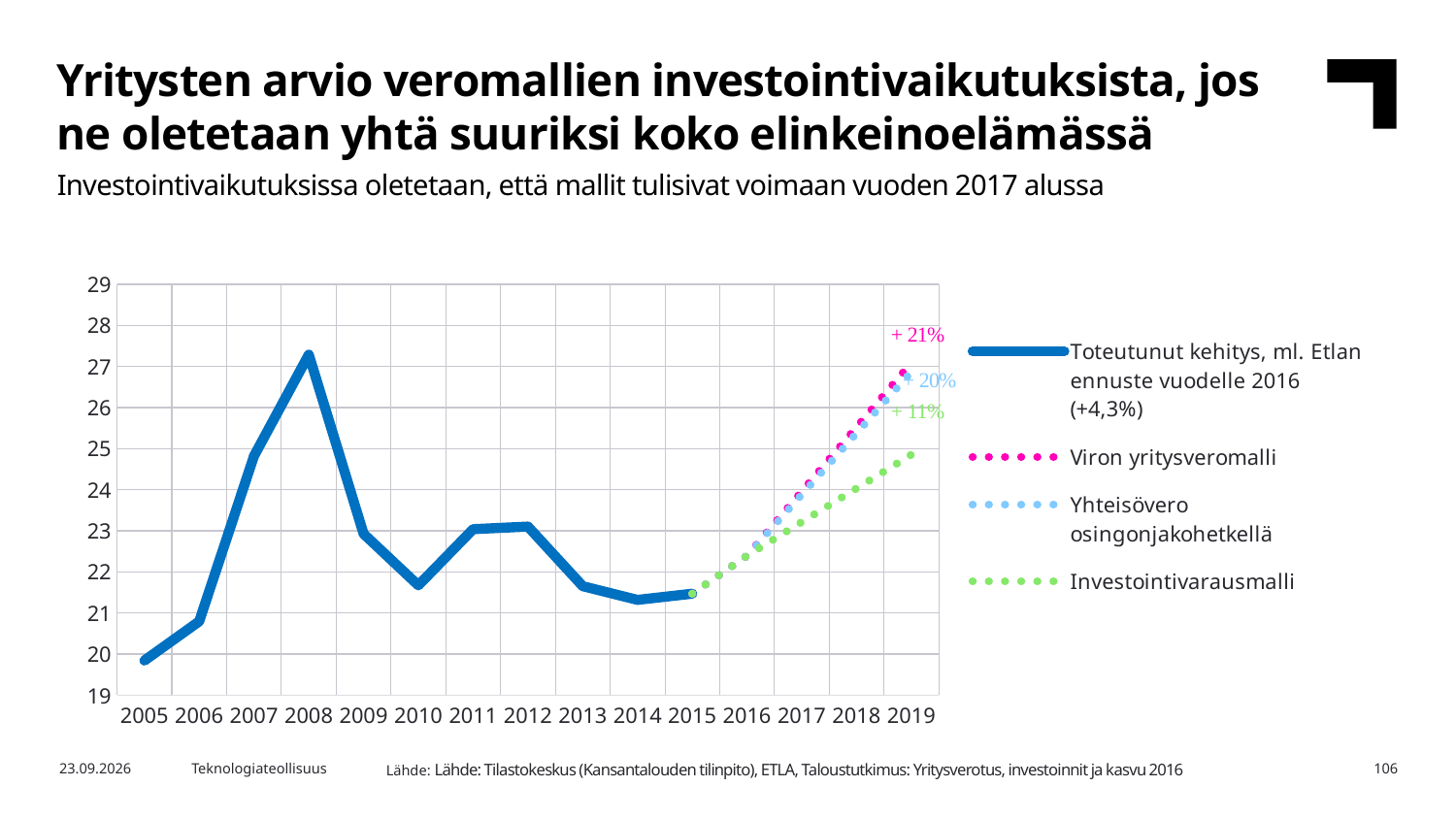
Which is larger for the solid blue line: the value in 2008 or the value in 2011? 2008 Is the value of the solid blue line in 2005 greater or less than 20? less What percentage change is labelled for the Viron yritysveromalli series at the end of the projection? + 21% What kind of chart is shown on the slide? line chart Does the solid blue line rise or fall between 2008 and 2010? fall How many series does the legend list? 4 What percentage change is labelled for the Investointivarausmalli series at the end of the projection? + 11% Which projected series ends lowest in 2019? Investointivarausmalli Is the value of the solid blue line in 2008 greater or less than 26? greater In which year does the solid blue line (Toteutunut kehitys) have its lowest value? 2005 What percentage change is labelled for the Yhteisövero osingonjakohetkellä series at the end of the projection? + 20% In which year does the solid blue line (Toteutunut kehitys) reach its highest value? 2008